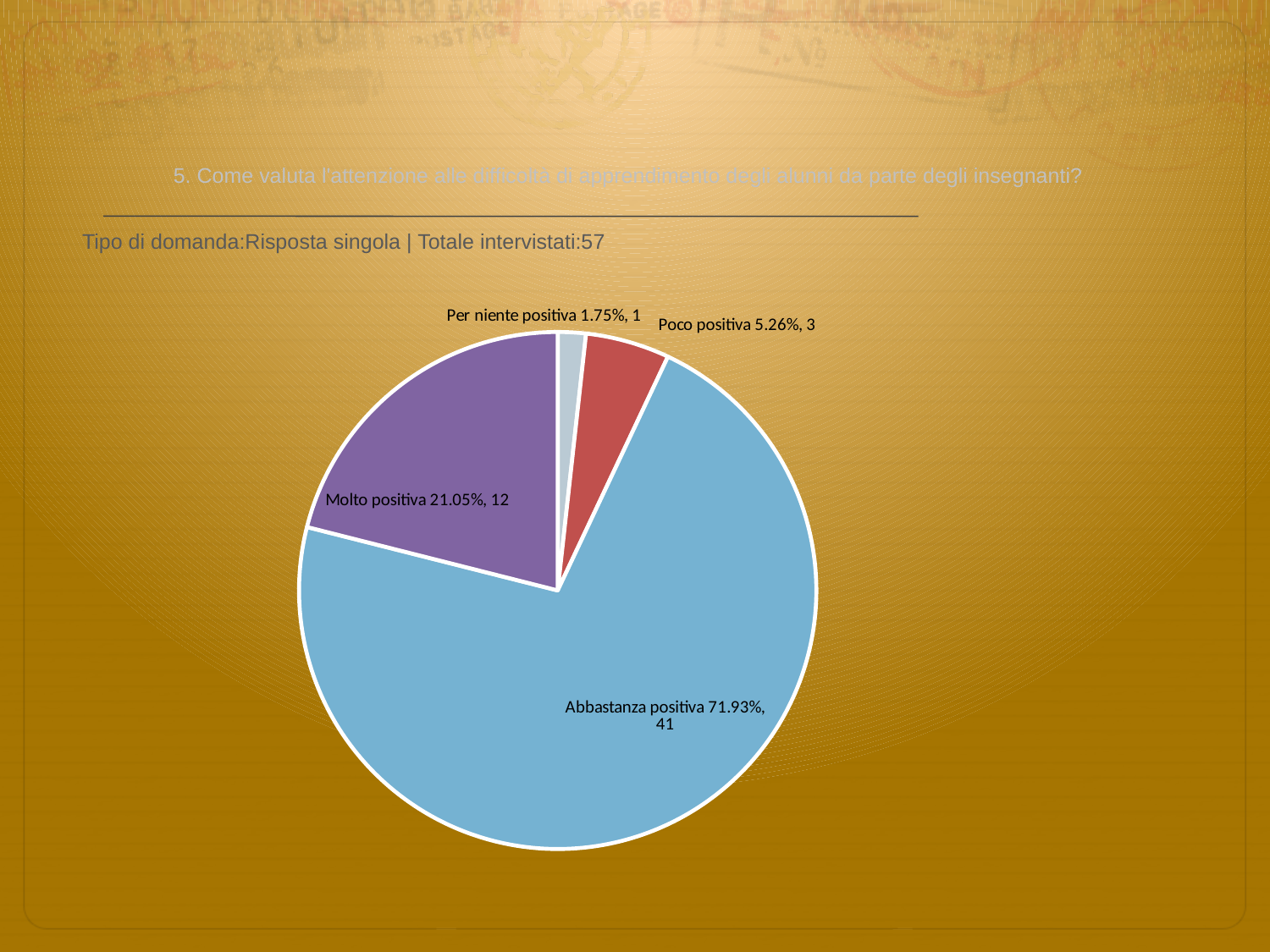
What is the difference in respondent count between 'Abbastanza positiva' and 'Molto positiva'? 29 Which has more respondents, 'Poco positiva' or 'Molto positiva'? Molto positiva How many respondents chose 'Molto positiva'? 12 What is the total number of respondents stated on the slide (Totale intervistati)? 57 How many slices does the pie chart have? 4 What kind of chart is shown on the slide? pie chart What percentage share does the 'Abbastanza positiva' slice have? 71.93% How many respondents chose 'Poco positiva'? 3 Which category has the largest slice? Abbastanza positiva What percentage share does the 'Per niente positiva' slice have? 1.75% Which category has the smallest slice? Per niente positiva What colour is the 'Molto positiva' slice? purple